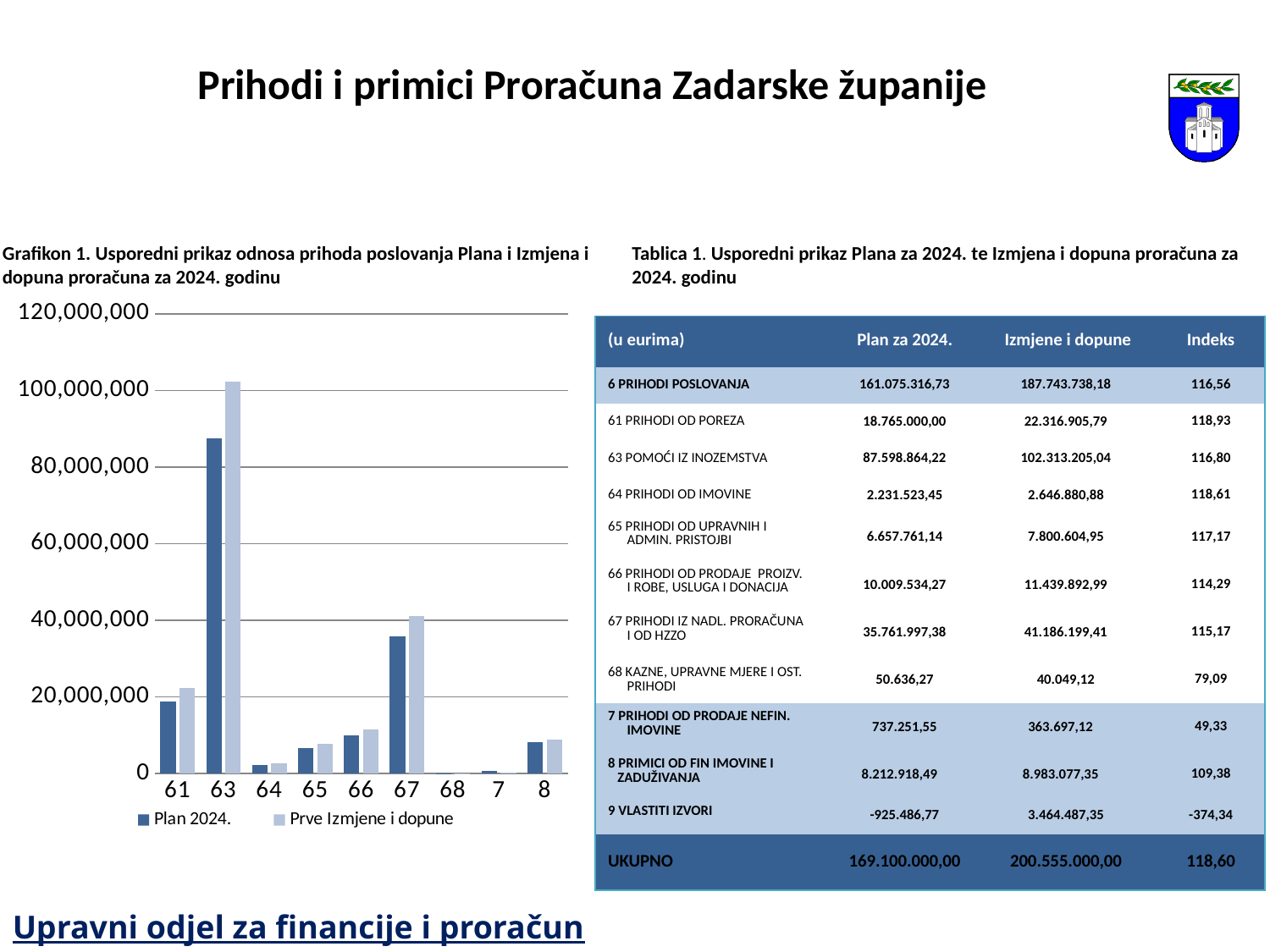
How many categories are shown on the x axis of the chart? 9 Is the Plan 2024. value for category 67 greater or less than 40,000,000? less How many series does the chart's legend list? 2 Which category has the highest value for the Plan 2024. series? 63 What are the two series named in the chart's legend? Plan 2024. and Prve Izmjene i dopune Is the Plan 2024. value for category 63 greater or less than 80,000,000? greater What is the highest value shown on the chart's vertical axis? 120,000,000 Which category has the highest value for the Prve Izmjene i dopune series? 63 Is the Prve Izmjene i dopune value for category 8 greater or less than 20,000,000? less For category 63, which series has the larger value, Plan 2024. or Prve Izmjene i dopune? Prve Izmjene i dopune For category 67, which series has the larger value, Plan 2024. or Prve Izmjene i dopune? Prve Izmjene i dopune What kind of chart is shown on the slide? bar chart